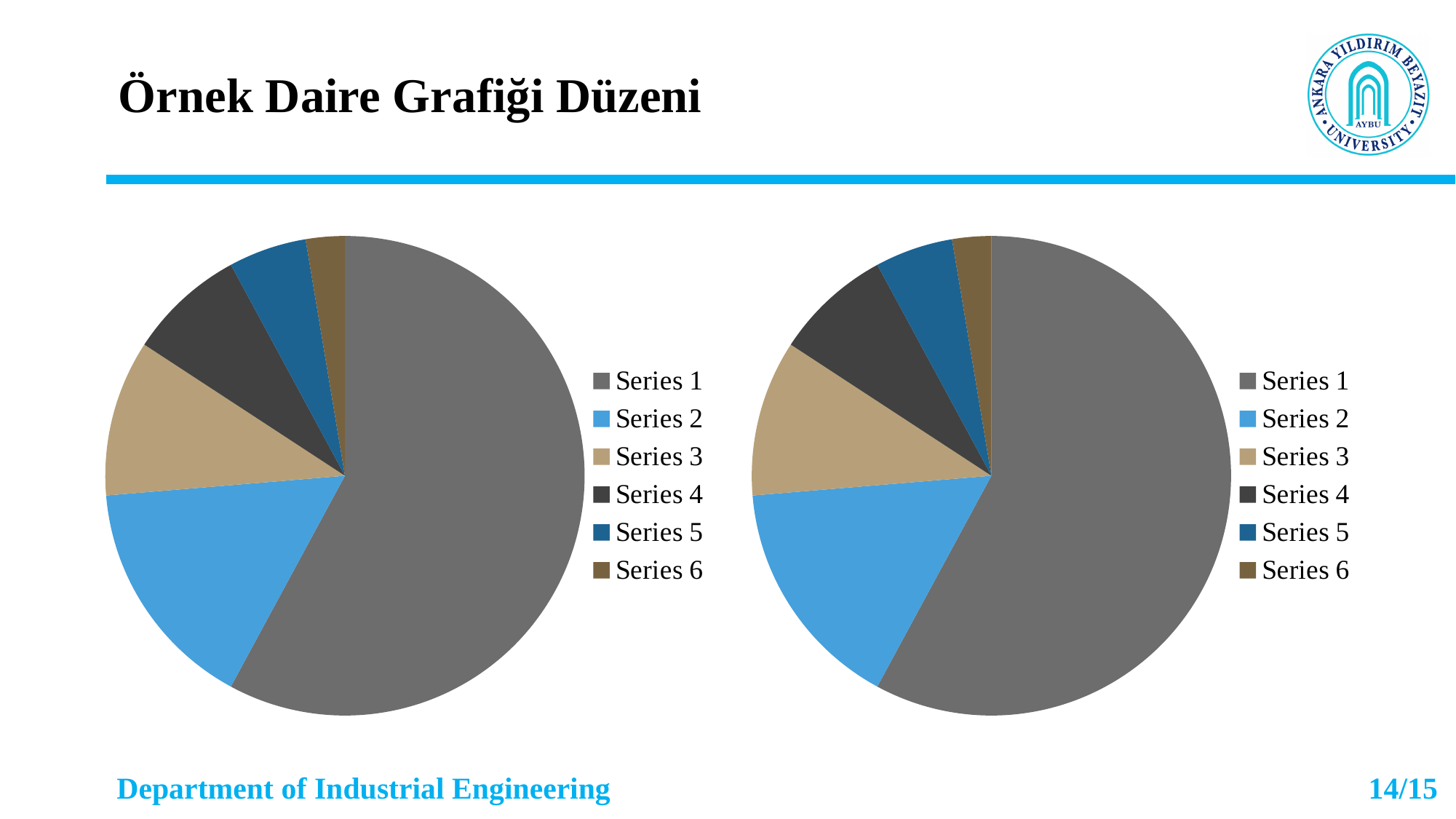
How many slices does the right pie chart have? 6 In the right pie chart, which slice is larger, Series 4 or Series 5? Series 4 In the right pie chart, which slice is larger, Series 1 or Series 2? Series 1 What kind of chart is the right chart on the slide? Pie chart In the left pie chart, which series has the largest slice? Series 1 In the left pie chart, which slice is larger, Series 2 or Series 3? Series 2 What colour is the Series 2 slice in the left pie chart? Blue What kind of chart is the left chart on the slide? Pie chart How many series does the legend of the left pie chart list? 6 In the right pie chart, which series has the largest slice? Series 1 What is the first entry listed in the legend of the right pie chart? Series 1